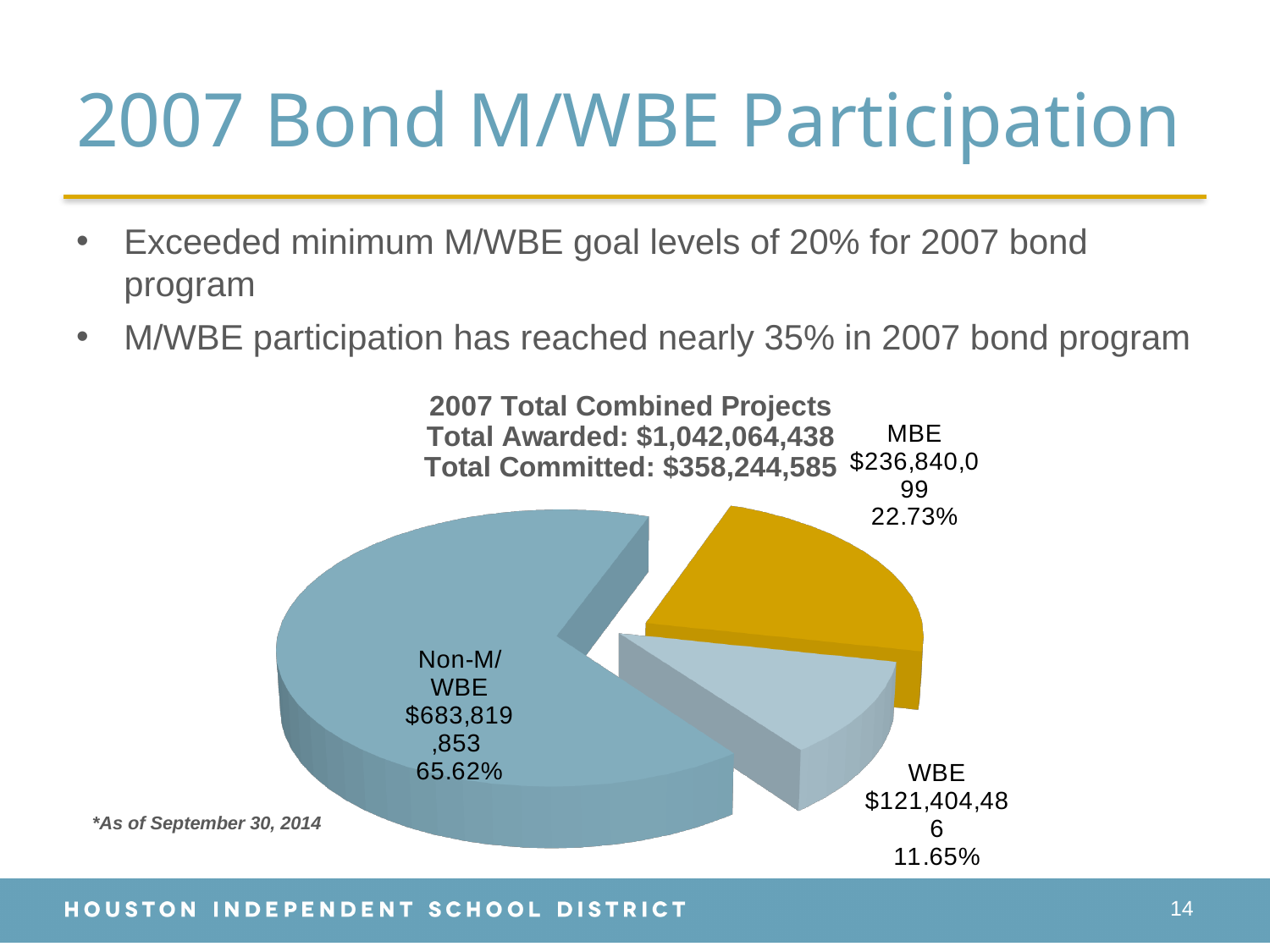
What kind of chart is shown on the slide? Pie chart What dollar value is shown for the Non-M/WBE slice? $683,819,853 How many slices does the pie chart have? 3 What percentage share does the MBE slice represent? 22.73% What dollar value is shown for the MBE slice? $236,840,099 What is the Total Awarded amount stated in the chart title? $1,042,064,438 What percentage share does the WBE slice represent? 11.65% Which slice of the pie chart is the smallest? WBE Which is larger, the MBE slice or the WBE slice? MBE Which slice of the pie chart is the largest? Non-M/WBE What is the Total Committed amount stated in the chart title? $358,244,585 What is the difference in percentage points between the MBE share and the WBE share? 11.08%